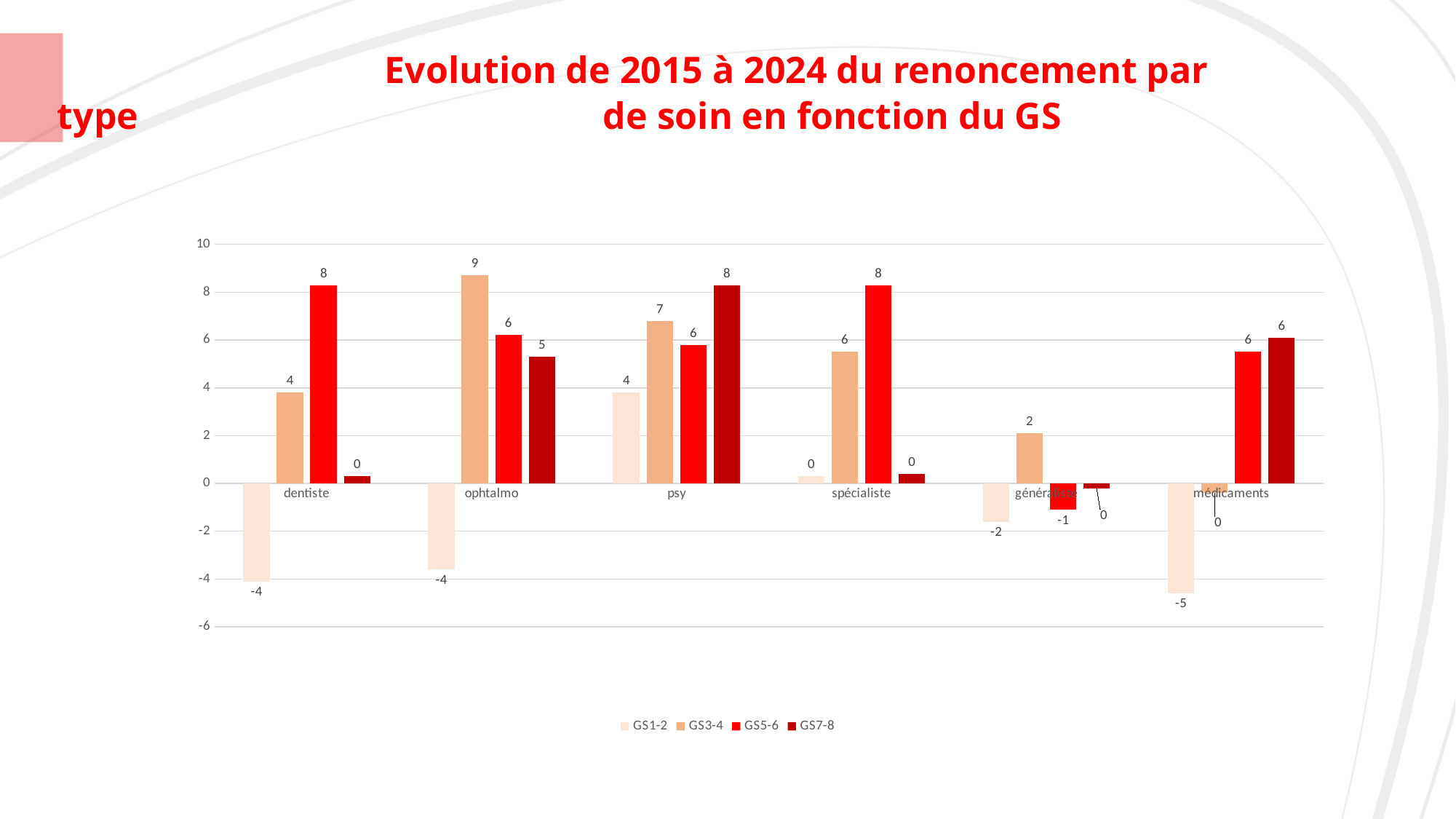
How many series does the legend list? 4 Is the value for GS3-4 in the ophtalmo category greater or less than 8? greater How many categories of care are shown on the x axis? 6 What is the value for GS1-2 in the médicaments category? -5 Which category has the highest value for the GS3-4 series? ophtalmo In the psy category, which is larger: the GS7-8 value or the GS1-2 value? GS7-8 Which category has the lowest value for the GS1-2 series? médicaments What is the value for GS7-8 in the psy category? 8 What is the value for GS3-4 in the ophtalmo category? 9 What is the value for GS5-6 in the généraliste category? -1 What kind of chart is shown on the slide? bar chart What is the difference between the GS5-6 value and the GS3-4 value in the dentiste category? 4